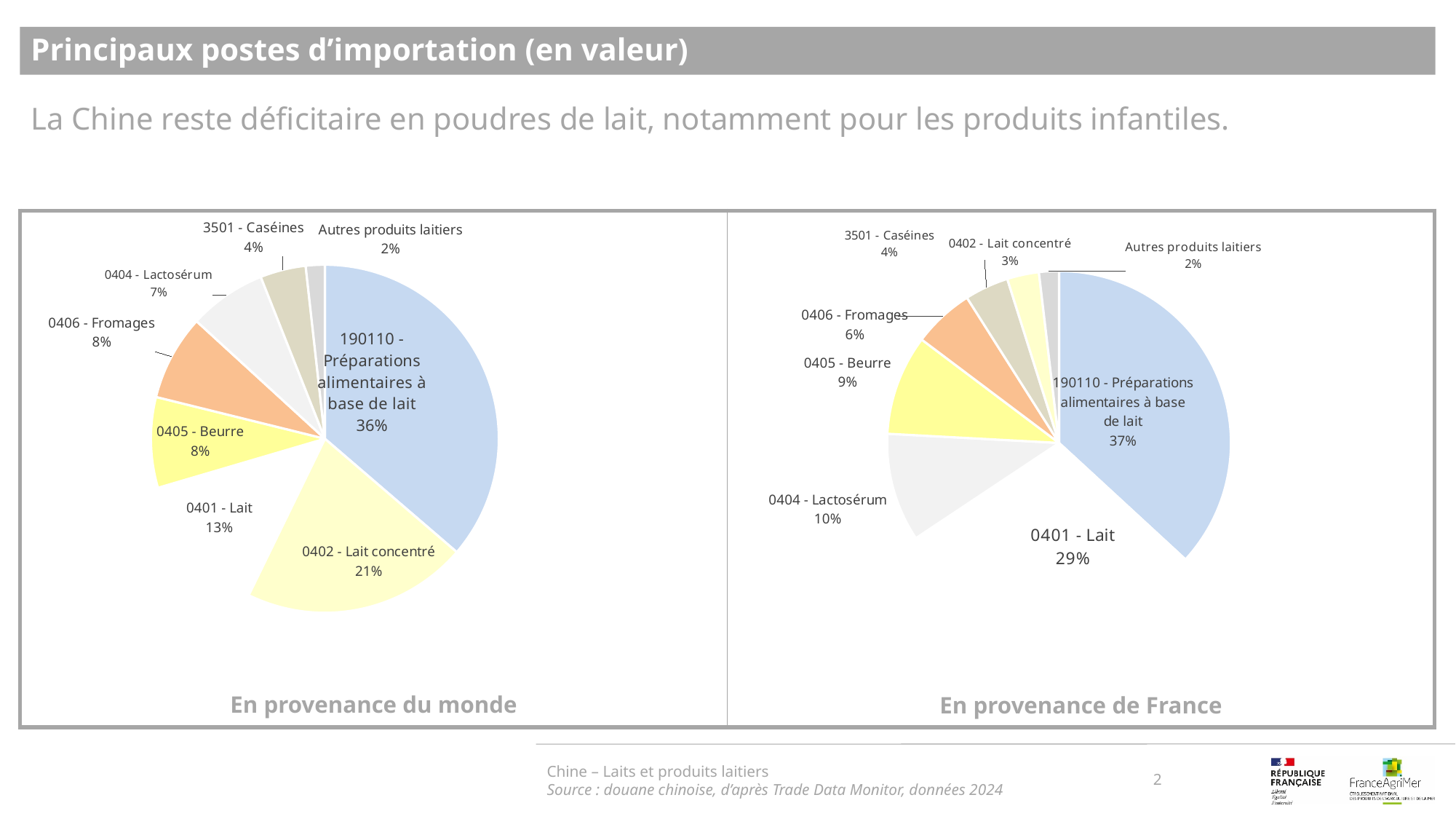
In the 'En provenance du monde' chart, which category has the largest share? 190110 - Préparations alimentaires à base de lait In the 'En provenance de France' chart, what share does '0401 - Lait' have? 29% In the 'En provenance du monde' chart, what is the share of '0401 - Lait'? 13% What is the title of the chart on the right side of the slide? En provenance de France In the 'En provenance de France' chart, which category has the smallest share? Autres produits laitiers What type of chart is used for 'En provenance de France'? Pie chart In the 'En provenance du monde' chart, what share does '0402 - Lait concentré' have? 21% In the 'En provenance du monde' chart, what is the difference between '0402 - Lait concentré' and '0404 - Lactosérum'? 14 percentage points In the 'En provenance de France' chart, which is larger: '0405 - Beurre' or '0406 - Fromages'? 0405 - Beurre What is the difference between the share of '0401 - Lait' in the 'En provenance de France' chart and in the 'En provenance du monde' chart? 16 percentage points In the 'En provenance de France' chart, what is the share of '0404 - Lactosérum'? 10% How many slices does the 'En provenance du monde' pie chart have? 8